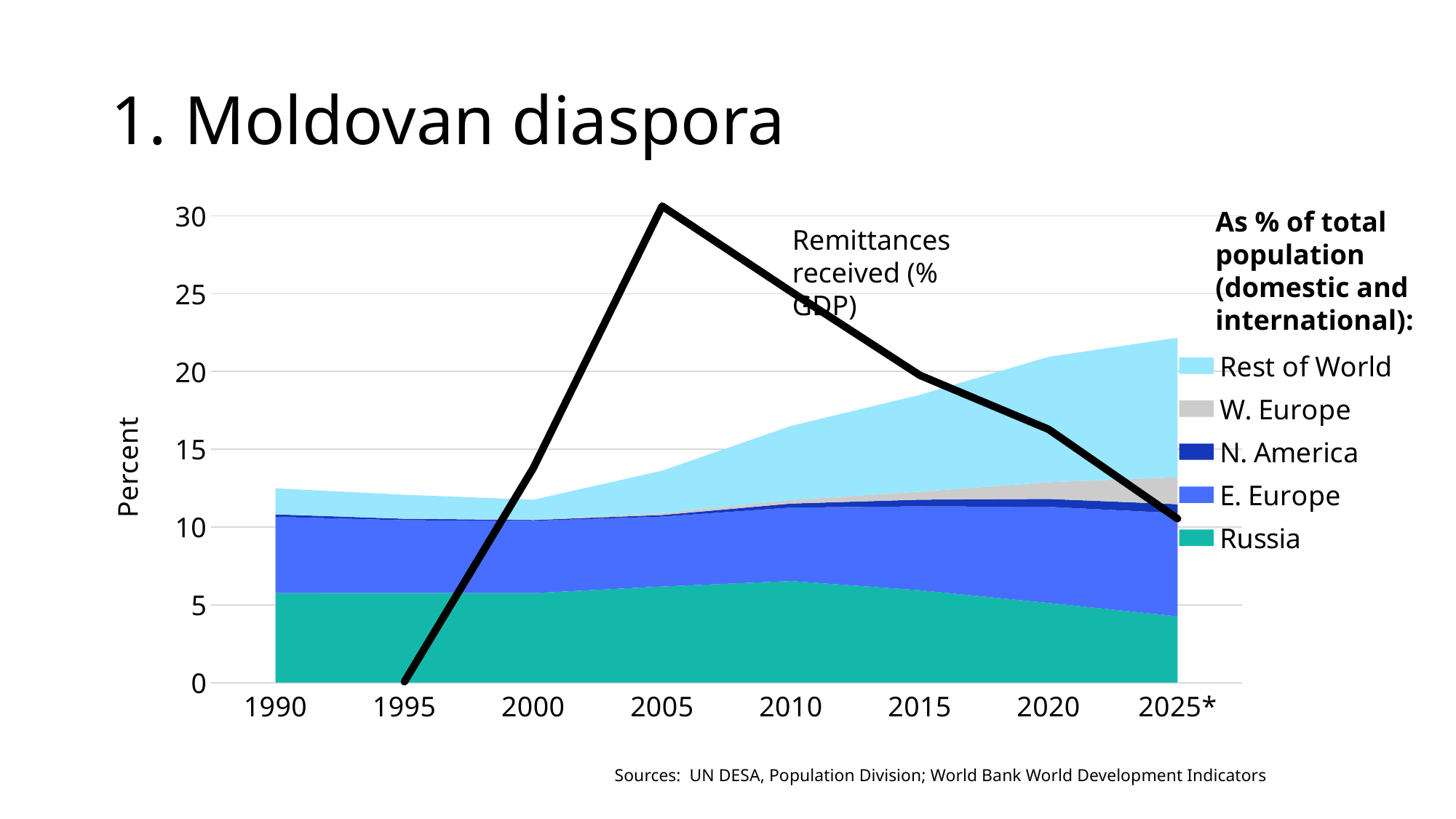
How many years are marked on the x axis? 8 Does the total height of the stacked area rise or fall between 2005 and 2025*? rise Does the 'Remittances received (% GDP)' line rise or fall between 2005 and 2025*? fall Is the value of the 'Remittances received (% GDP)' line in 2025* greater or less than 15? less What kind of chart is shown on the slide? stacked area chart with a line overlay Is the value of the 'Remittances received (% GDP)' line in 2005 greater or less than 25? greater How many series does the legend under 'As % of total population' list? 5 Is the total of the stacked area in 2025* greater or less than 20? greater What is the label on the y axis? Percent In which year does the 'Remittances received (% GDP)' line reach its peak? 2005